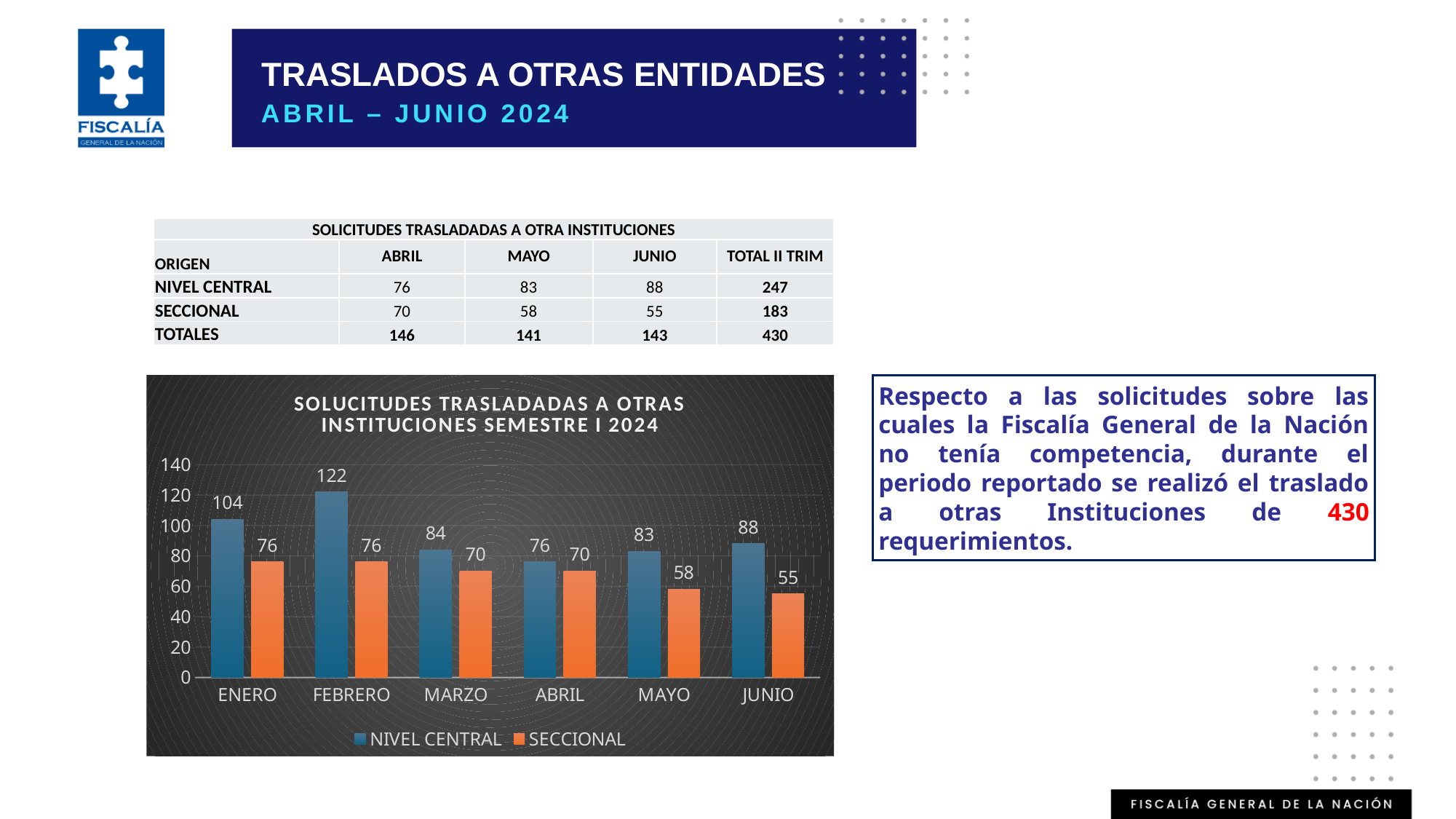
Is the value for NIVEL CENTRAL in MARZO greater or less than 100? less Which is larger in ABRIL, NIVEL CENTRAL or SECCIONAL? NIVEL CENTRAL How many series does the chart legend list? 2 What kind of chart is shown on the slide? bar chart What is the difference between NIVEL CENTRAL and SECCIONAL in ENERO? 28 Does the SECCIONAL series rise or fall from MARZO to JUNIO? fall What is the value for NIVEL CENTRAL in JUNIO? 88 Which month has the lowest SECCIONAL value? JUNIO How many months are shown on the x axis of the chart? 6 What is the value for NIVEL CENTRAL in FEBRERO? 122 Which month has the highest NIVEL CENTRAL value? FEBRERO What is the value for SECCIONAL in MAYO? 58